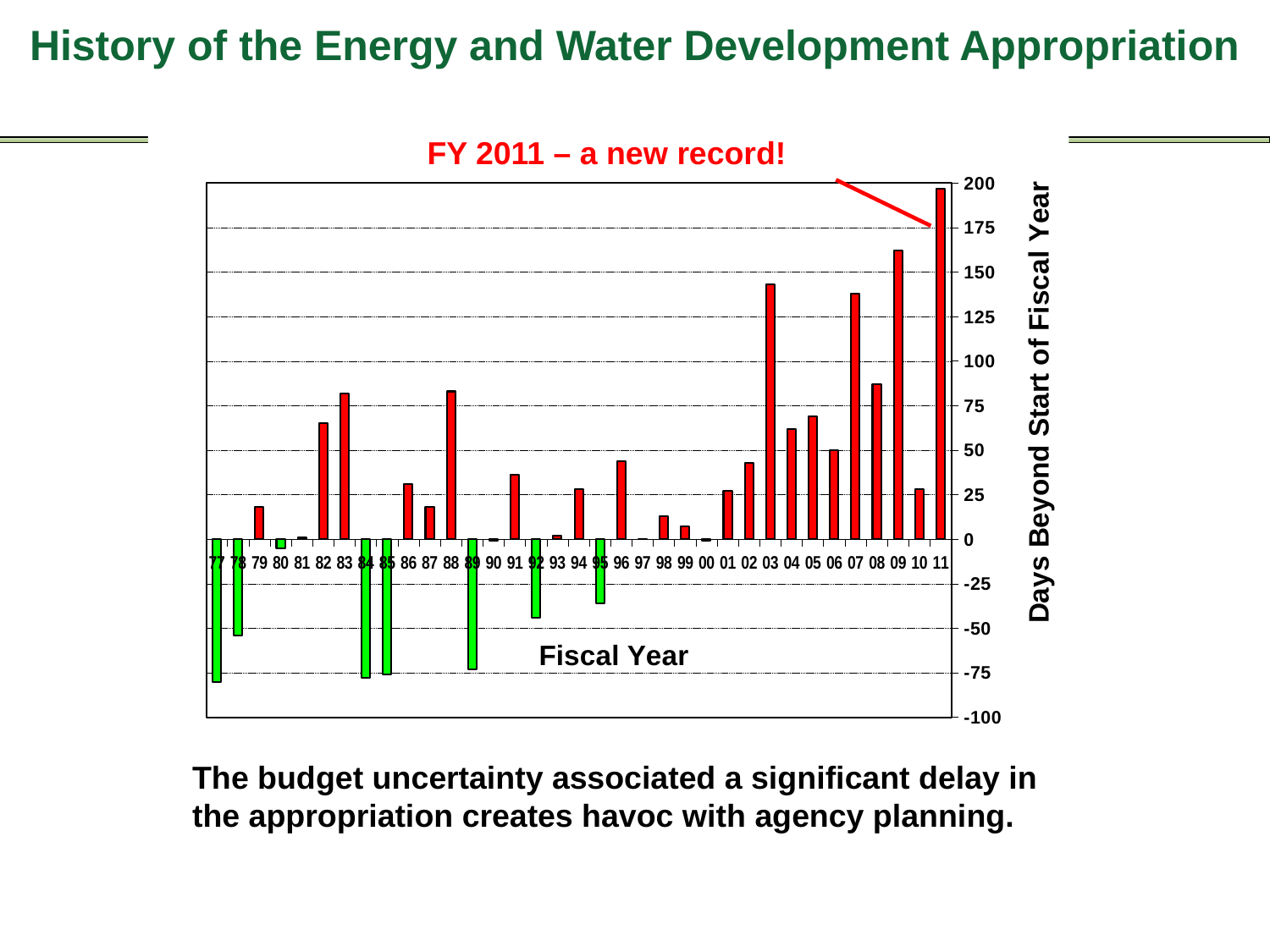
Is the value for fiscal year 09 greater or less than 150? greater Is the value for fiscal year 03 greater or less than 125? greater Which fiscal year has the larger value, 09 or 11? 11 How many fiscal years are plotted along the x axis? 35 Is the value for fiscal year 92 greater or less than -25? less What kind of chart is shown on the slide? bar chart Which fiscal year has the highest number of days beyond the start of the fiscal year? 11 What is the title of the vertical axis? Days Beyond Start of Fiscal Year Which fiscal year has the larger value, 82 or 86? 82